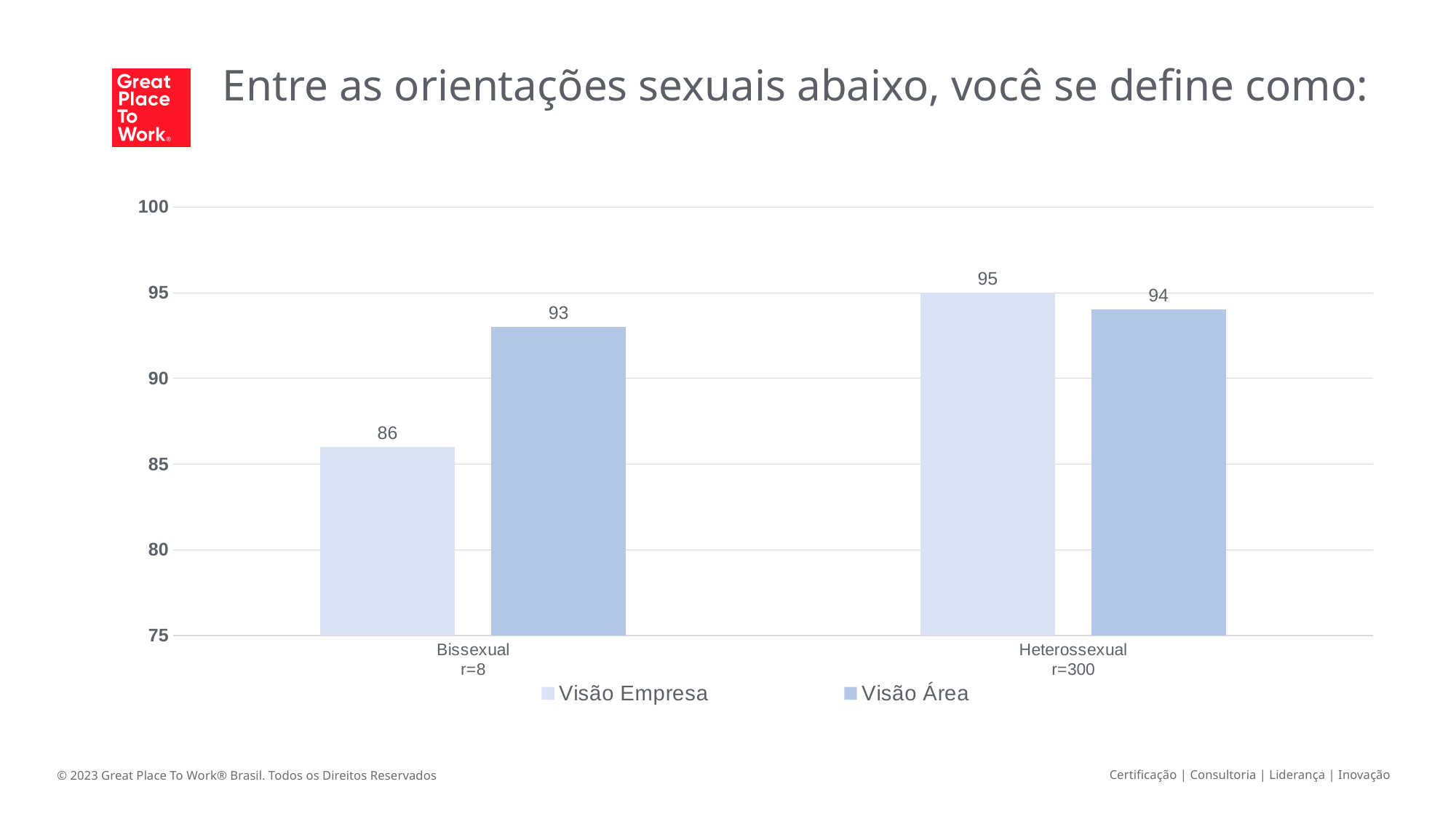
How many series does the legend list? 2 What is the difference between the Visão Empresa values for Heterossexual and Bissexual? 9 What is the Visão Empresa value for Bissexual? 86 Which category has the lowest Visão Área value? Bissexual For Heterossexual, which is larger: Visão Empresa or Visão Área? Visão Empresa What is the Visão Empresa value for Heterossexual? 95 What is the Visão Área value for Bissexual? 93 What kind of chart is shown on the slide? Bar chart How many categories are shown on the x axis? 2 What is the Visão Área value for Heterossexual? 94 Which category has the highest Visão Empresa value? Heterossexual What is the difference between the Visão Área and Visão Empresa values for Bissexual? 7